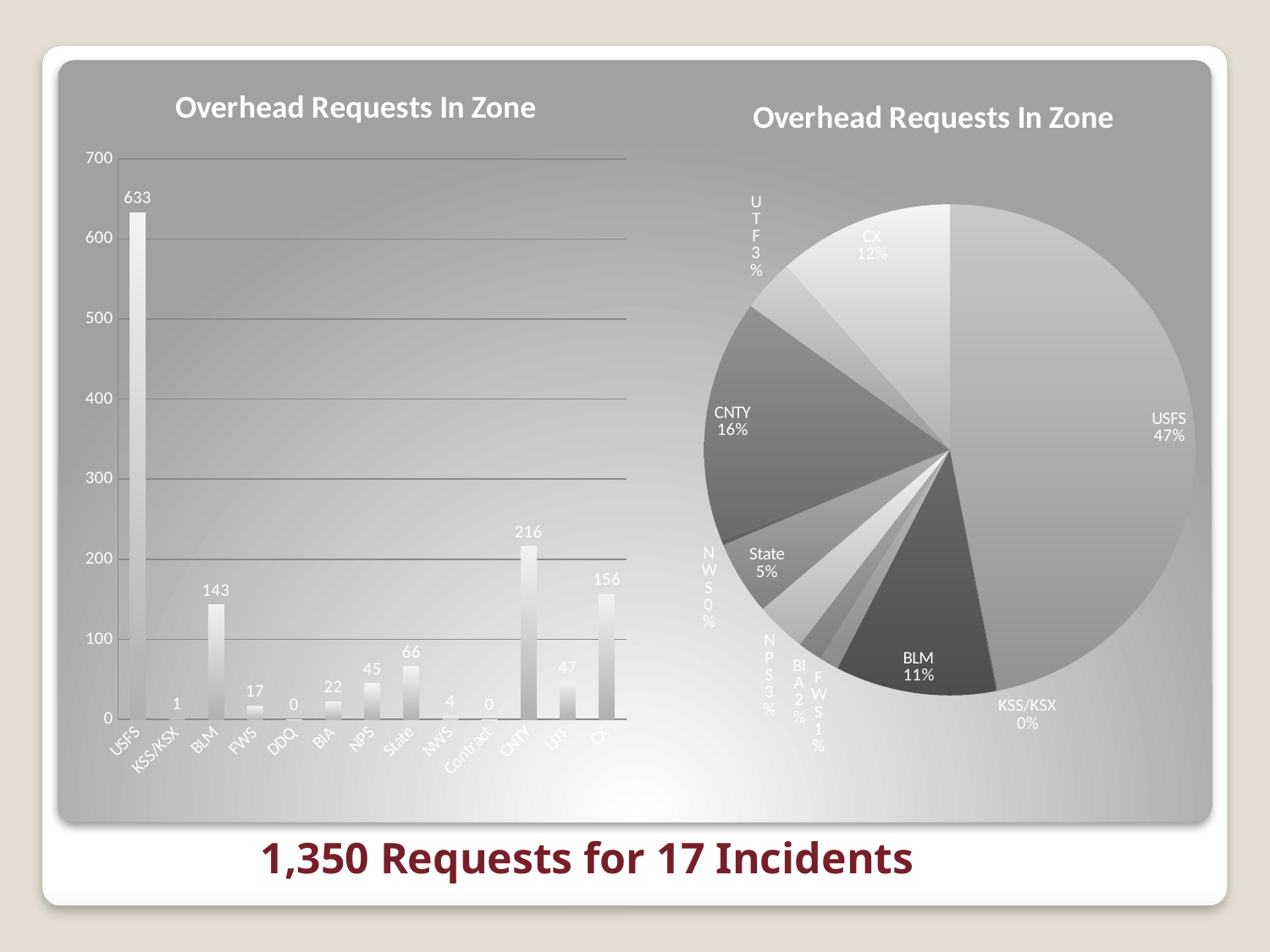
In the bar chart on the left, what is the value for UTF? 47 In the bar chart on the left, what is the value for BLM? 143 In the bar chart on the left, which category has the highest value? USFS What kind of chart is the chart on the left side of the slide? Bar chart In the pie chart on the right, what share of the pie does CNTY have? 16% What is the title of the bar chart on the left? Overhead Requests In Zone In the bar chart on the left, which is larger, the value for CX or the value for BLM? CX In the bar chart on the left, what is the value for CNTY? 216 In the bar chart on the left, how many categories are shown on the x axis? 13 In the bar chart on the left, what is the difference between the values for USFS and CNTY? 417 What kind of chart is the chart on the right side of the slide? Pie chart In the pie chart on the right, what share of the pie does USFS have? 47%